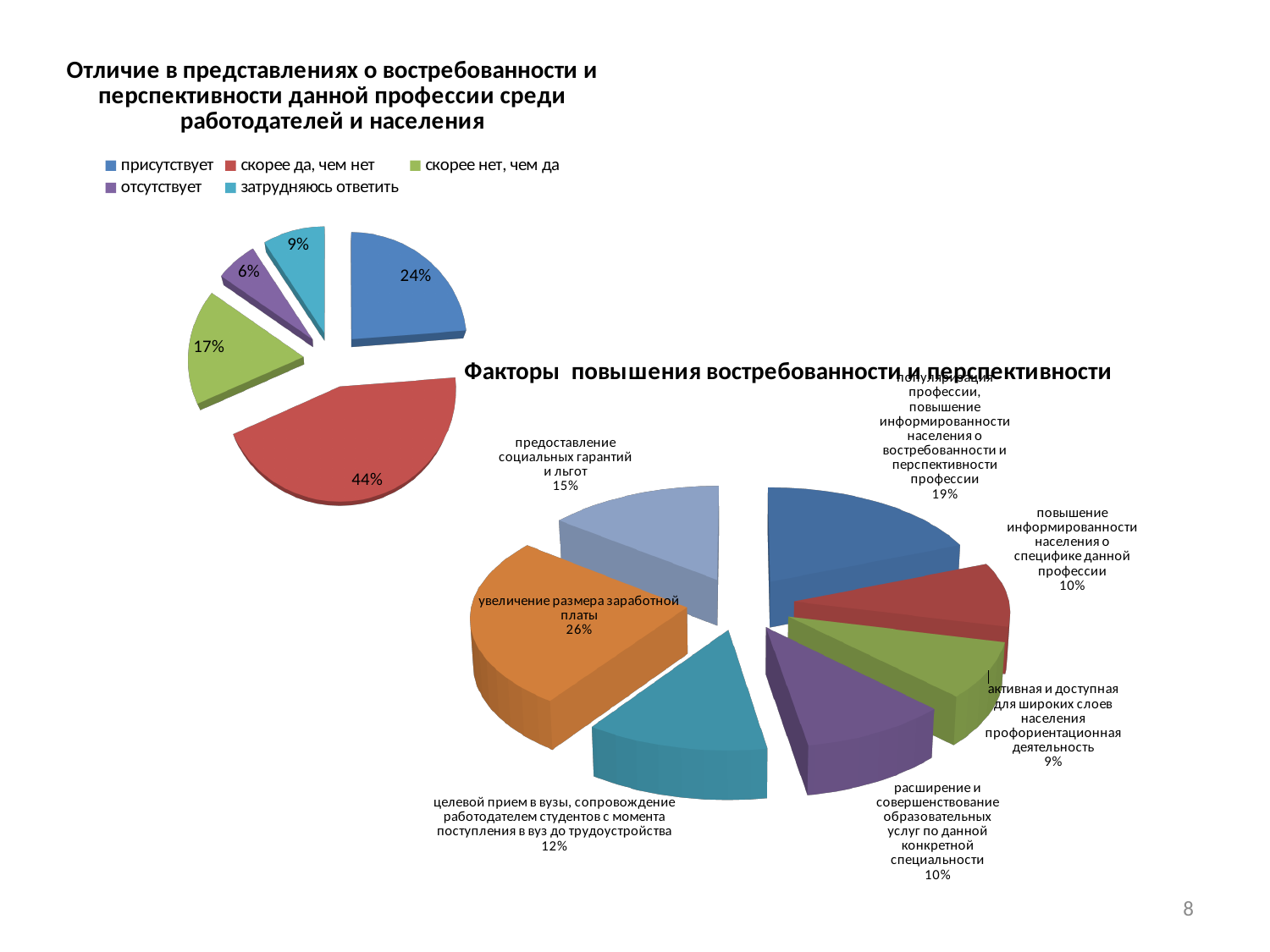
In the chart titled "Отличие в представлениях о востребованности и перспективности данной профессии среди работодателей и населения", what is the difference between the shares for "присутствует" and "скорее нет, чем да"? 7% In the chart titled "Отличие в представлениях о востребованности и перспективности данной профессии среди работодателей и населения", how many entries does the legend list? 5 In the chart titled "Факторы повышения востребованности и перспективности", which is larger: the share for "целевой прием в вузы, сопровождение работодателем студентов с момента поступления в вуз до трудоустройства" or the share for "повышение информированности населения о специфике данной профессии"? целевой прием в вузы, сопровождение работодателем студентов с момента поступления в вуз до трудоустройства In the chart titled "Факторы повышения востребованности и перспективности", what share is labelled for "предоставление социальных гарантий и льгот"? 15% In the chart titled "Факторы повышения востребованности и перспективности", what share is labelled for "увеличение размера заработной платы"? 26% In the chart titled "Отличие в представлениях о востребованности и перспективности данной профессии среди работодателей и населения", which category has the smallest slice? отсутствует In the chart titled "Факторы повышения востребованности и перспективности", how many slices does the pie have? 7 In the chart titled "Отличие в представлениях о востребованности и перспективности данной профессии среди работодателей и населения", which category has the largest slice? скорее да, чем нет In the chart titled "Отличие в представлениях о востребованности и перспективности данной профессии среди работодателей и населения", what share is labelled for "отсутствует"? 6% In the chart titled "Факторы повышения востребованности и перспективности", which factor has the smallest slice? активная и доступная для широких слоев населения профориентационная деятельность What kind of chart is the one titled "Факторы повышения востребованности и перспективности"? pie chart In the chart titled "Отличие в представлениях о востребованности и перспективности данной профессии среди работодателей и населения", what share is labelled for "скорее да, чем нет"? 44%